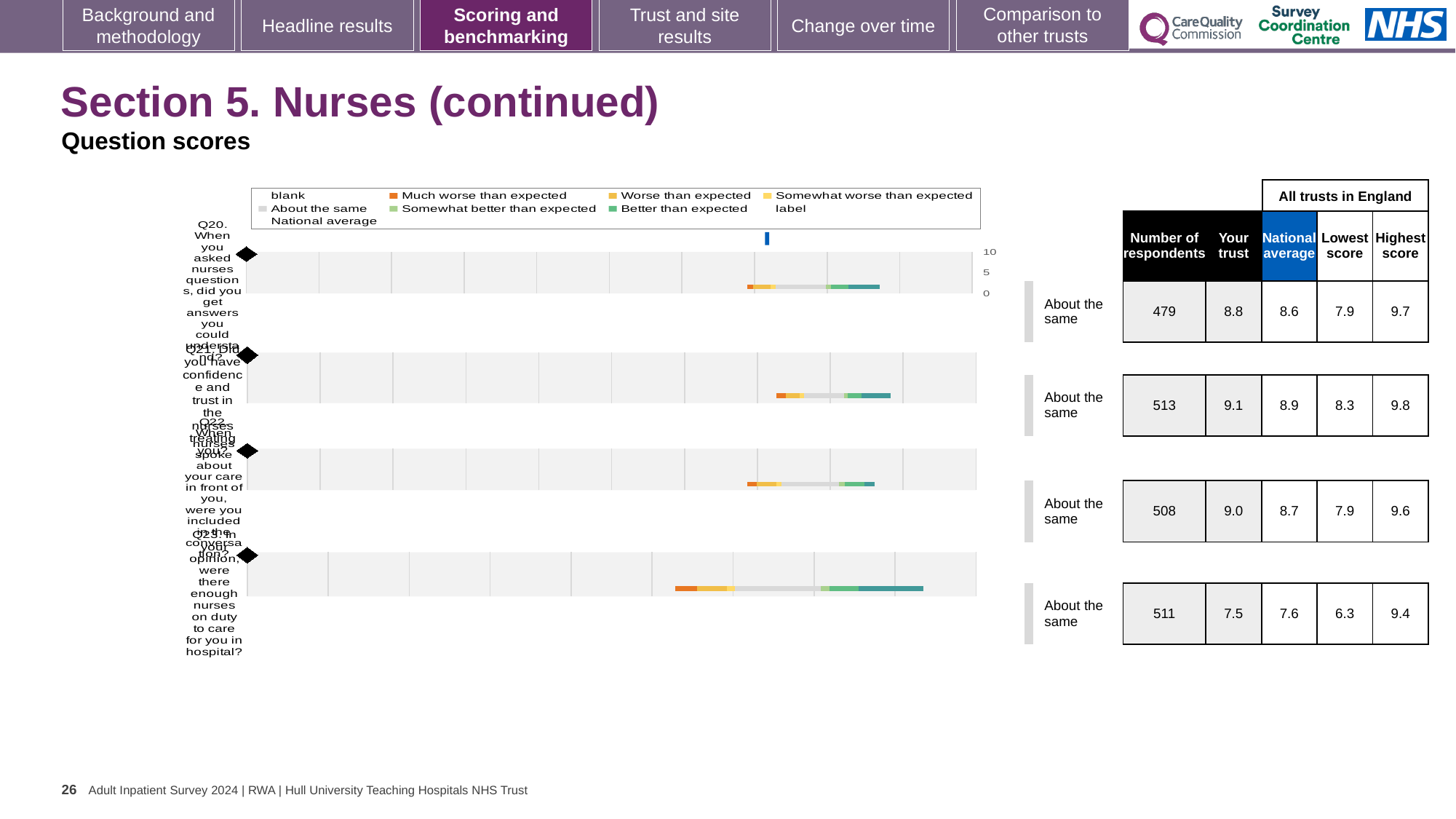
In the legend, what colour represents 'Much worse than expected'? Orange For the Q20 chart, what is the difference between the 'Your trust' score and the national average? 0.2 For the Q20 chart, what is the 'Your trust' score? 8.8 What kind of chart is used to show the question scores for Q20 to Q23? Bar chart Which question chart has the lowest 'Your trust' score? Q23 For the Q22 chart, which is larger: the 'Your trust' score or the national average? Your trust Which question chart has the highest 'Your trust' score? Q21 How many question charts (Q20 to Q23) are shown on the slide? 4 For the Q22 chart, how many respondents are there? 508 For the Q23 chart, what is the lowest score among all trusts in England? 6.3 For the Q21 chart, what is the national average score? 8.9 What is the maximum value shown on the score axis of the Q20 chart? 10